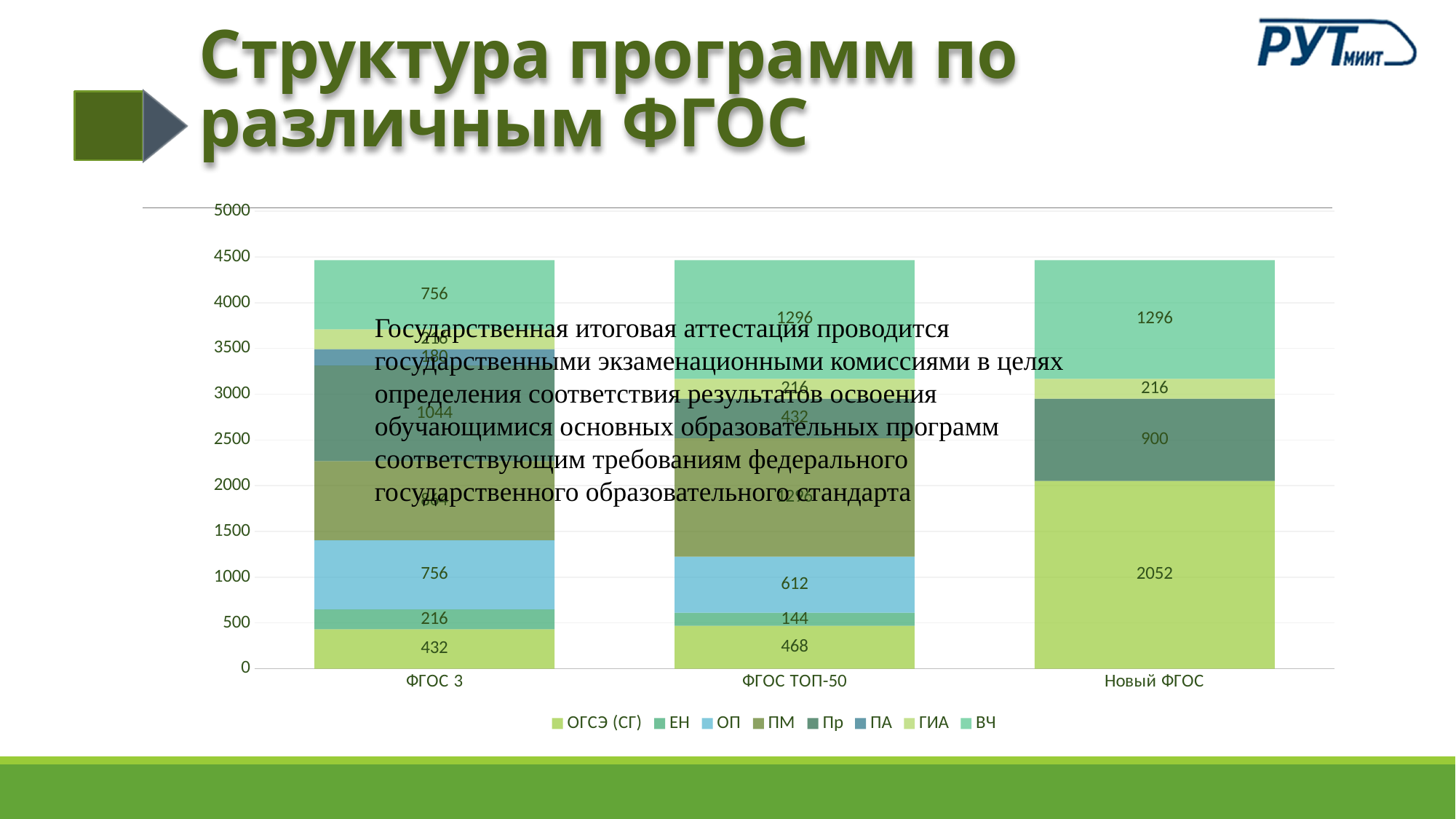
What type of chart is shown on the slide? Stacked bar chart Which is larger, the ВЧ value for ФГОС 3 or for ФГОС ТОП-50? ФГОС ТОП-50 What is the value of Пр for Новый ФГОС? 900 How many series does the chart legend list? 8 Which category has the highest value for ОГСЭ (СГ)? Новый ФГОС How many categories are shown on the x axis of the chart? 3 Is the total height of the ФГОС 3 stacked bar greater or less than 4000? greater What is the value of ЕН for ФГОС 3? 216 What is the value of ОГСЭ (СГ) for Новый ФГОС? 2052 What is the difference between the ОГСЭ (СГ) values for Новый ФГОС and ФГОС 3? 1620 What is the value of ОП for ФГОС ТОП-50? 612 What is the first entry in the chart legend? ОГСЭ (СГ)